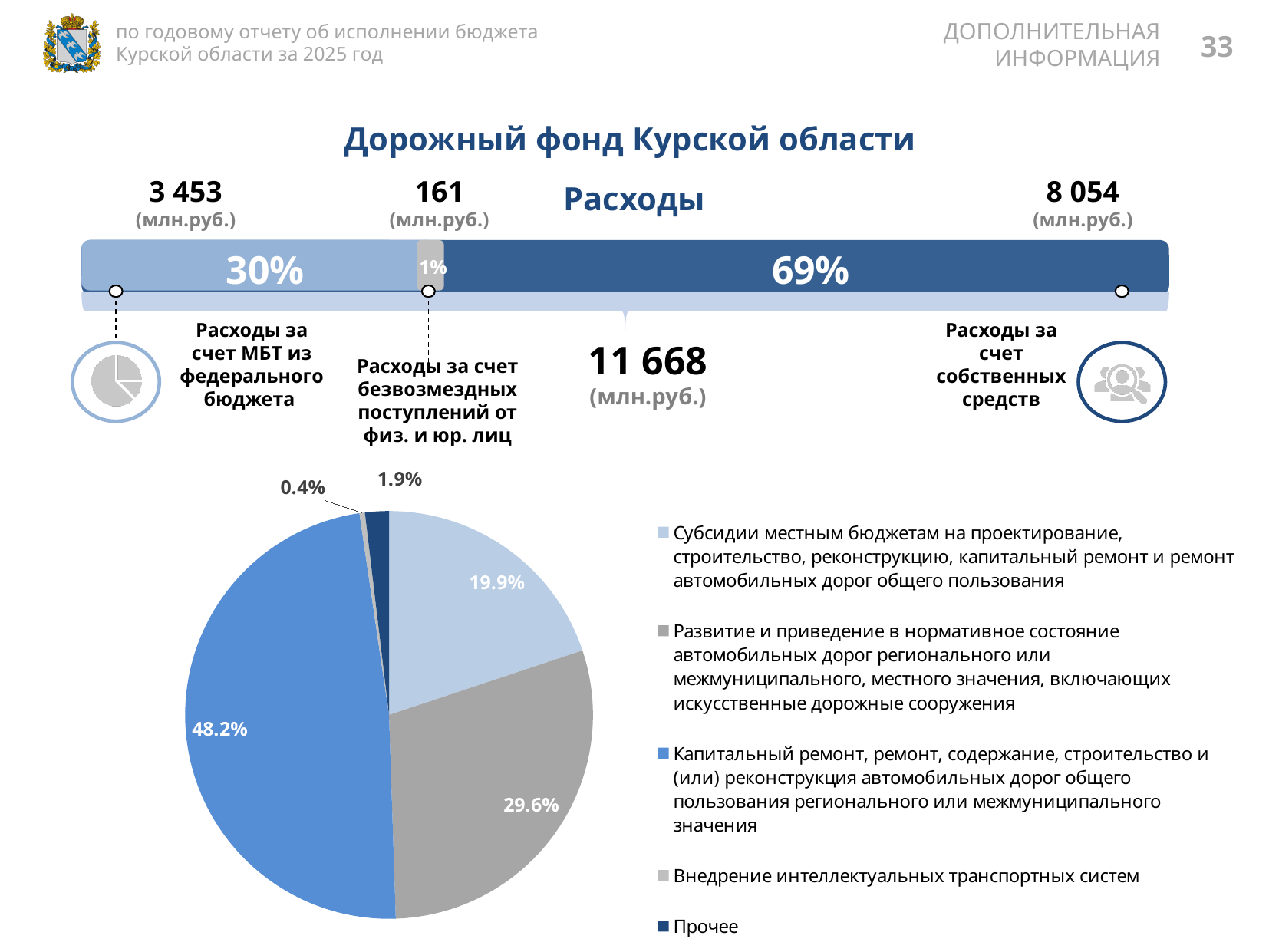
In the pie chart, what share is labelled for 'Внедрение интеллектуальных транспортных систем'? 0.4% In the pie chart, what share is labelled for 'Развитие и приведение в нормативное состояние автомобильных дорог регионального или межмуниципального, местного значения, включающих искусственные дорожные сооружения'? 29.6% In the pie chart, what share is labelled for 'Субсидии местным бюджетам на проектирование, строительство, реконструкцию, капитальный ремонт и ремонт автомобильных дорог общего пользования'? 19.9% In the horizontal bar at the top of the slide, what is the value in млн.руб. for 'Расходы за счет собственных средств'? 8 054 Which slice of the pie chart is the smallest? Внедрение интеллектуальных транспортных систем In the horizontal bar at the top of the slide, what percentage is shown for 'Расходы за счет МБТ из федерального бюджета'? 30% In the pie chart, what is the difference in percentage points between the 48.2% slice and the 29.6% slice? 18.6 What kind of chart is shown in the lower left of the slide? pie chart How many slices does the pie chart have? 5 Which slice of the pie chart is the largest? Капитальный ремонт, ремонт, содержание, строительство и (или) реконструкция автомобильных дорог общего пользования регионального или межмуниципального значения